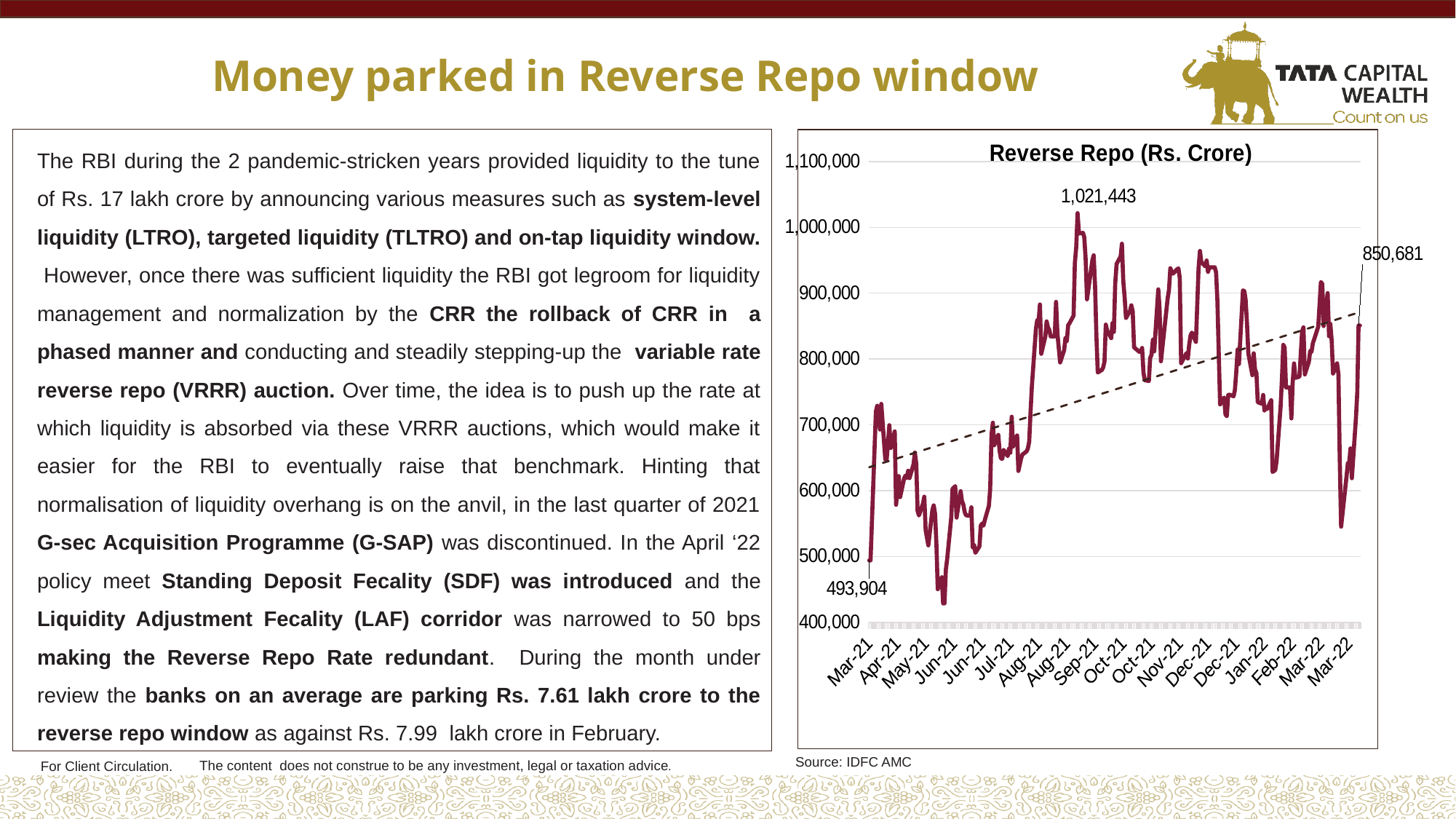
What source is cited below the chart? IDFC AMC What value is labelled at the start of the series in Mar-21? 493,904 What is the difference between the final labelled value of 850,681 and the starting value of 493,904? 356,777 Which is larger: the labelled value at the start of the series (Mar-21) or at the end (Mar-22)? Mar-22 (850,681) What is the highest value labelled on the Reverse Repo chart? 1,021,443 What is the difference between the peak value of 1,021,443 and the starting value of 493,904? 527,539 What kind of chart is shown on the slide? line chart Does the dashed trend line on the chart rise or fall from Mar-21 to Mar-22? rises What value is labelled at the end of the series in Mar-22? 850,681 What is the title of the chart? Reverse Repo (Rs. Crore) Is the lowest point of the series, around Jun-21, greater or less than 500,000? less Is the peak value of the series greater or less than 1,000,000? greater